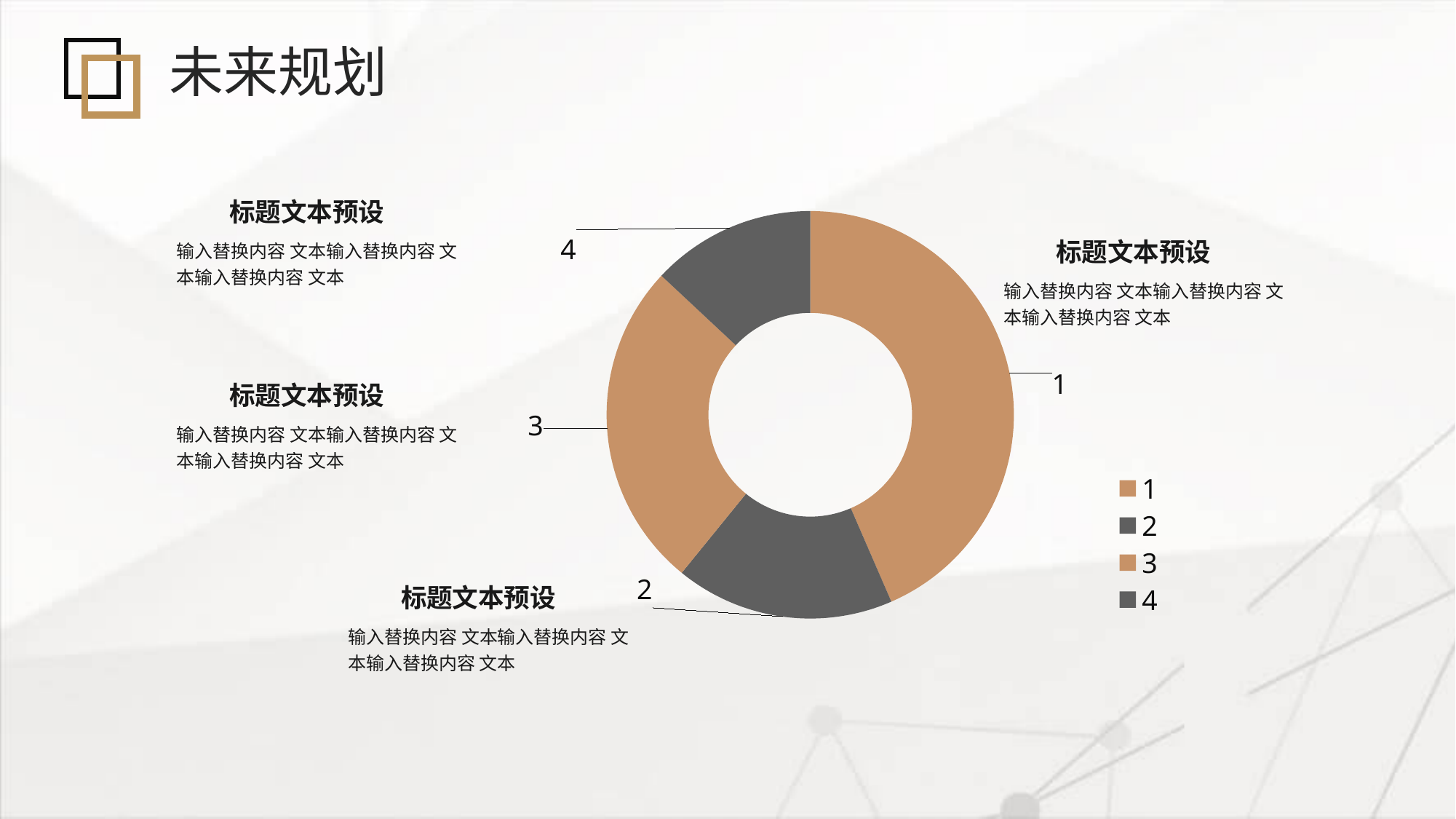
Which slice is larger, slice 1 or slice 3? 1 What is the title of the slide containing the doughnut chart? 未来规划 What kind of chart is shown on the slide? Doughnut (pie) chart What colour are slices 1 and 3 in the doughnut chart? Tan/brown Which slice is larger, slice 3 or slice 2? 3 Which slice is larger, slice 2 or slice 4? 2 Which slice of the doughnut chart is the smallest? 4 How many slices does the doughnut chart have? 4 Which slice of the doughnut chart is the largest? 1 How many entries does the chart legend list? 4